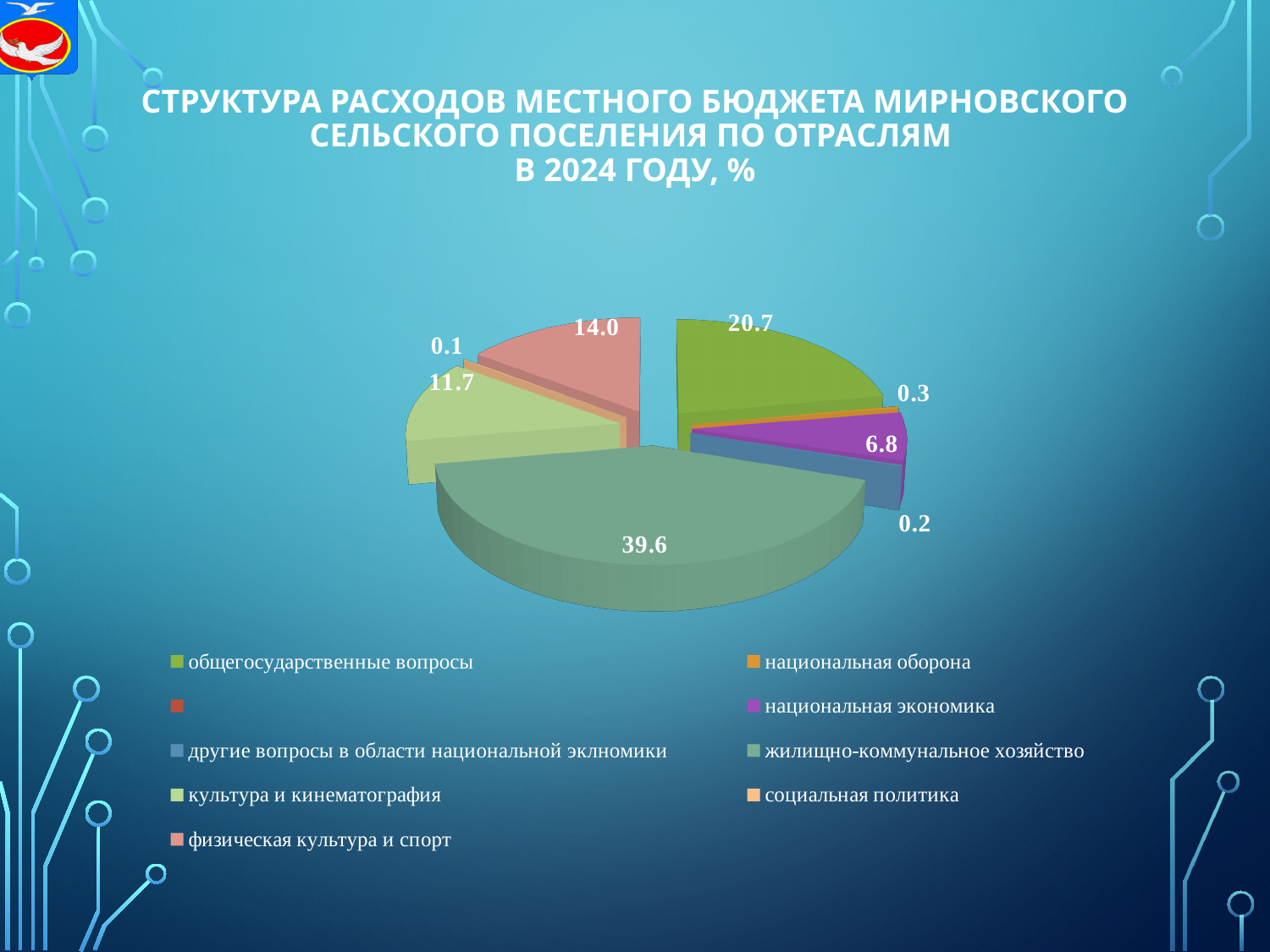
What is the difference between the values for жилищно-коммунальное хозяйство and общегосударственные вопросы? 18.9 What is the difference between the values for национальная оборона and социальная политика? 0.2 What year does the chart title refer to? 2024 What is the value for физическая культура и спорт? 14.0 Which is larger: физическая культура и спорт or культура и кинематография? физическая культура и спорт What is the value for культура и кинематография? 11.7 Which category has the smallest share of the pie? социальная политика What share of expenditure goes to жилищно-коммунальное хозяйство? 39.6 What is the value for национальная экономика? 6.8 What is the value for общегосударственные вопросы? 20.7 What kind of chart is shown on the slide? pie chart Which category has the largest share of the pie? жилищно-коммунальное хозяйство